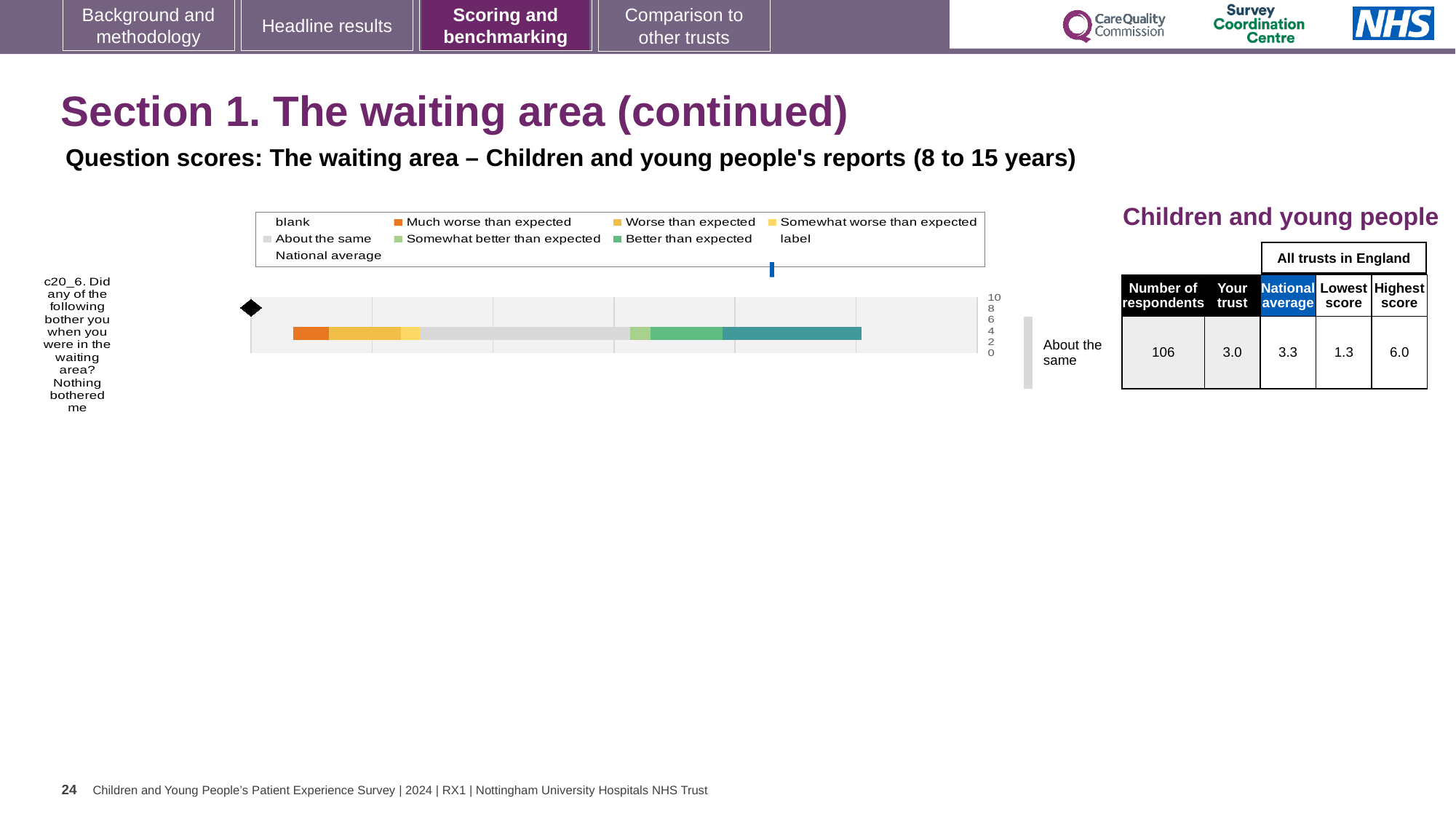
Which question is plotted on the chart? c20_6. Did any of the following bother you when you were in the waiting area? Nothing bothered me What rating label is shown to the right of the chart for question c20_6? About the same According to the table beside the chart, what is the national average for question c20_6? 3.3 What kind of chart is shown on the slide? bar chart What colour does the legend use for 'Much worse than expected'? orange According to the table beside the chart, what is the trust's score for question c20_6? 3.0 What is the highest tick value shown on the chart's axis? 10 How many entries does the chart's legend list? 9 What is the difference between the highest score and the lowest score for question c20_6 in the table? 4.7 How many question categories are plotted on the chart? 1 Which is larger for question c20_6, the trust's score or the national average? national average According to the table beside the chart, how many respondents answered question c20_6? 106